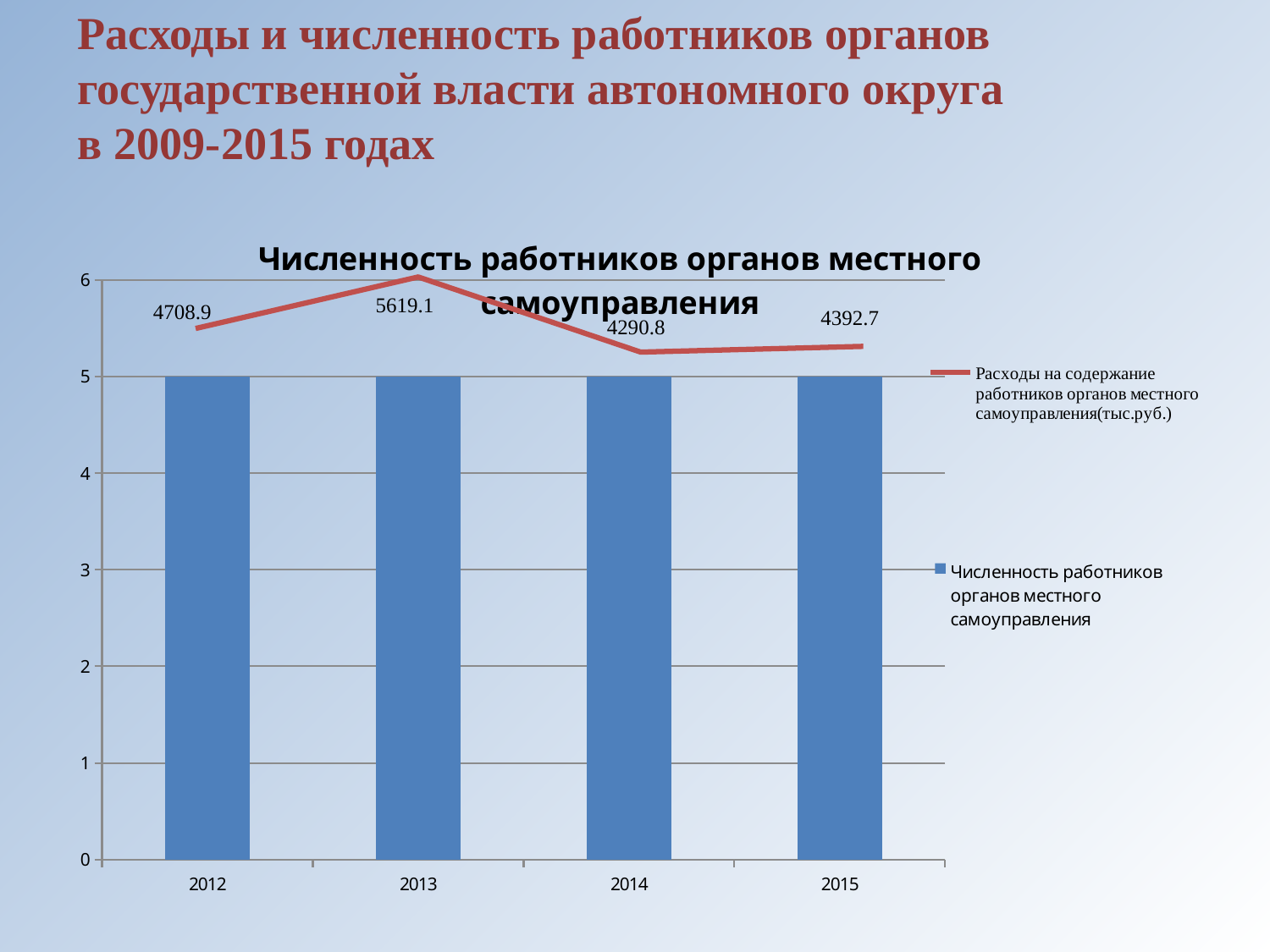
How many series does the chart legend list? 2 What is the difference between the 'Расходы' values for 2013 and 2014? 1328.3 What is the value of the 'Расходы на содержание работников органов местного самоуправления' line for 2015? 4392.7 What is the value of the 'Расходы на содержание работников органов местного самоуправления' line for 2013? 5619.1 In which year is the 'Расходы на содержание работников органов местного самоуправления' value lowest? 2014 What is the value of the 'Численность работников органов местного самоуправления' bar for 2014? 5 Which year has a larger 'Расходы' value, 2012 or 2015? 2012 In which year is the 'Расходы на содержание работников органов местного самоуправления' value highest? 2013 How many years are shown on the x axis of the chart? 4 What is the title of the chart? Численность работников органов местного самоуправления Does the 'Расходы' line rise or fall from 2013 to 2014? fall What is the value of the 'Расходы на содержание работников органов местного самоуправления' line for 2012? 4708.9